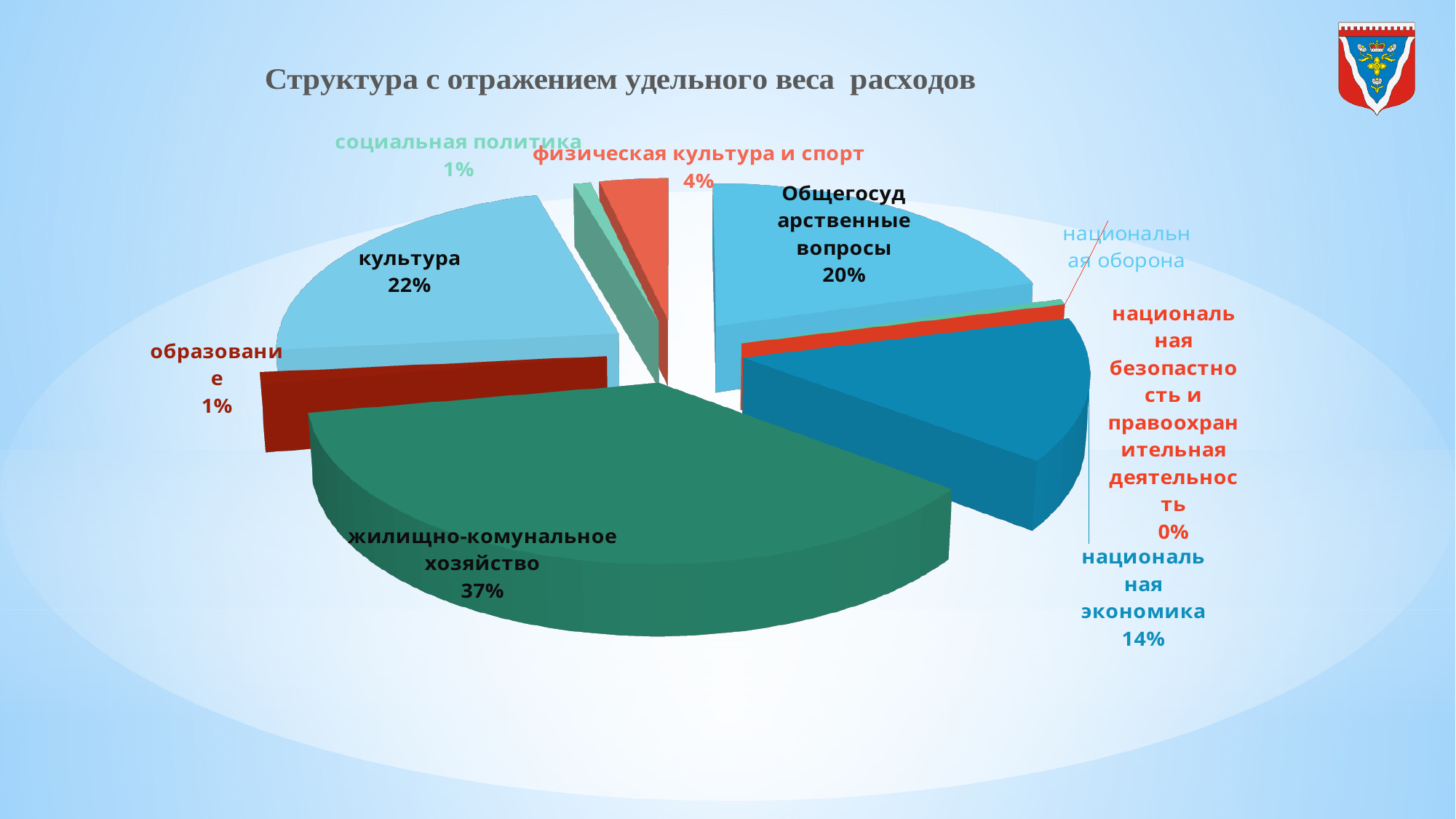
What share of the pie does Общегосударственные вопросы have? 20% What share of the pie does культура have? 22% What share of the pie does жилищно-комунальное хозяйство have? 37% Which is larger, the share for культура or the share for Общегосударственные вопросы? культура What is the difference between the share for жилищно-комунальное хозяйство and the share for национальная экономика? 23% How many categories are labelled on the pie chart? 9 What kind of chart is shown on the slide? pie chart What is the title of the chart? Структура с отражением удельного веса расходов Which category has the largest share of the pie? жилищно-комунальное хозяйство